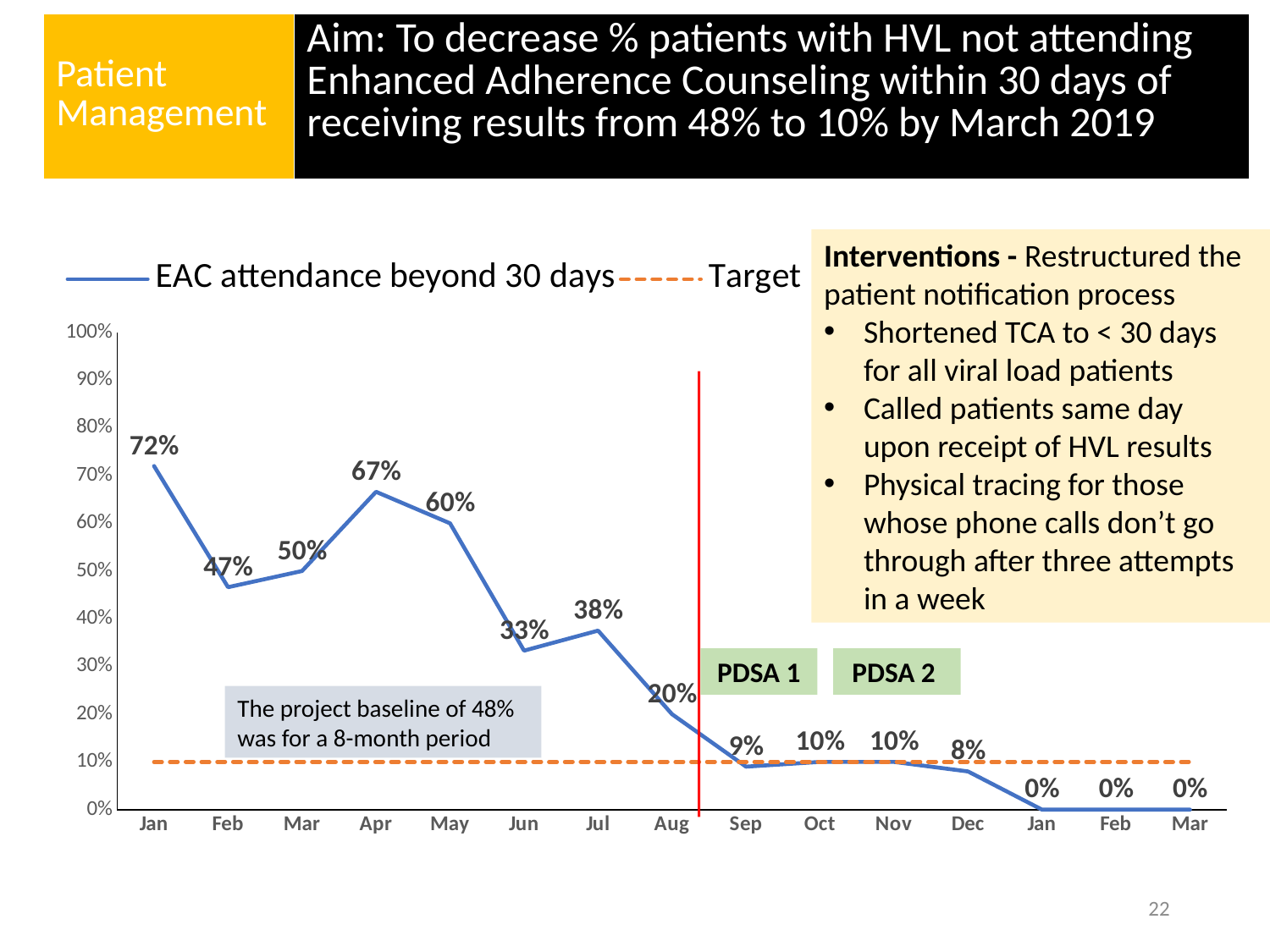
What is the EAC attendance beyond 30 days value for Aug? 20% Is the EAC attendance beyond 30 days value for Sep greater or less than 10%? less What value does the dashed Target line sit at? 10% What is the EAC attendance beyond 30 days value for Apr? 67% How many months are plotted on the x axis? 15 What is the EAC attendance beyond 30 days value for Dec? 8% Which month has the highest EAC attendance beyond 30 days value? Jan (the first Jan) What kind of chart is shown on the slide? line chart How many series does the legend list? 2 What is the difference between the EAC attendance beyond 30 days values for Apr and Jun? 34% Which is larger, the EAC attendance beyond 30 days value for May or for Jul? May Do the EAC attendance beyond 30 days values generally rise or fall from Apr to the final Mar? fall